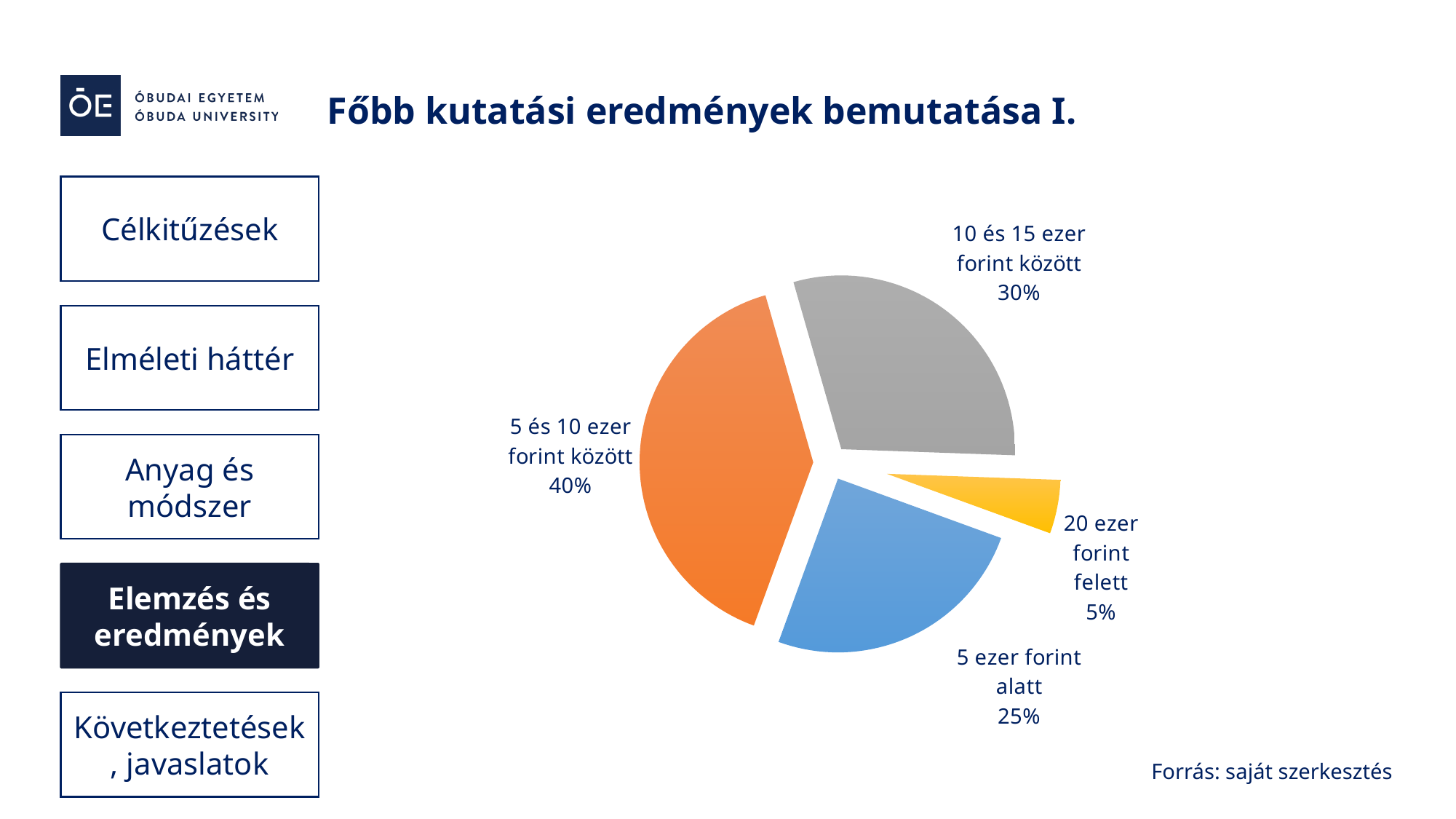
What is the difference in percentage points between the "5 és 10 ezer forint között" slice and the "5 ezer forint alatt" slice? 15 percentage points What kind of chart is shown on the slide? Pie chart What share of the pie is labelled "10 és 15 ezer forint között"? 30% How many slices does the pie chart have? 4 What colour is the "5 ezer forint alatt" slice? Blue Which slice of the pie chart is the largest? 5 és 10 ezer forint között What share of the pie is labelled "5 és 10 ezer forint között"? 40% Which is larger: the "10 és 15 ezer forint között" slice or the "5 ezer forint alatt" slice? 10 és 15 ezer forint között What share of the pie is labelled "20 ezer forint felett"? 5% Which slice of the pie chart is the smallest? 20 ezer forint felett What source is given for the chart at the bottom right of the slide? Forrás: saját szerkesztés What share of the pie is labelled "5 ezer forint alatt"? 25%